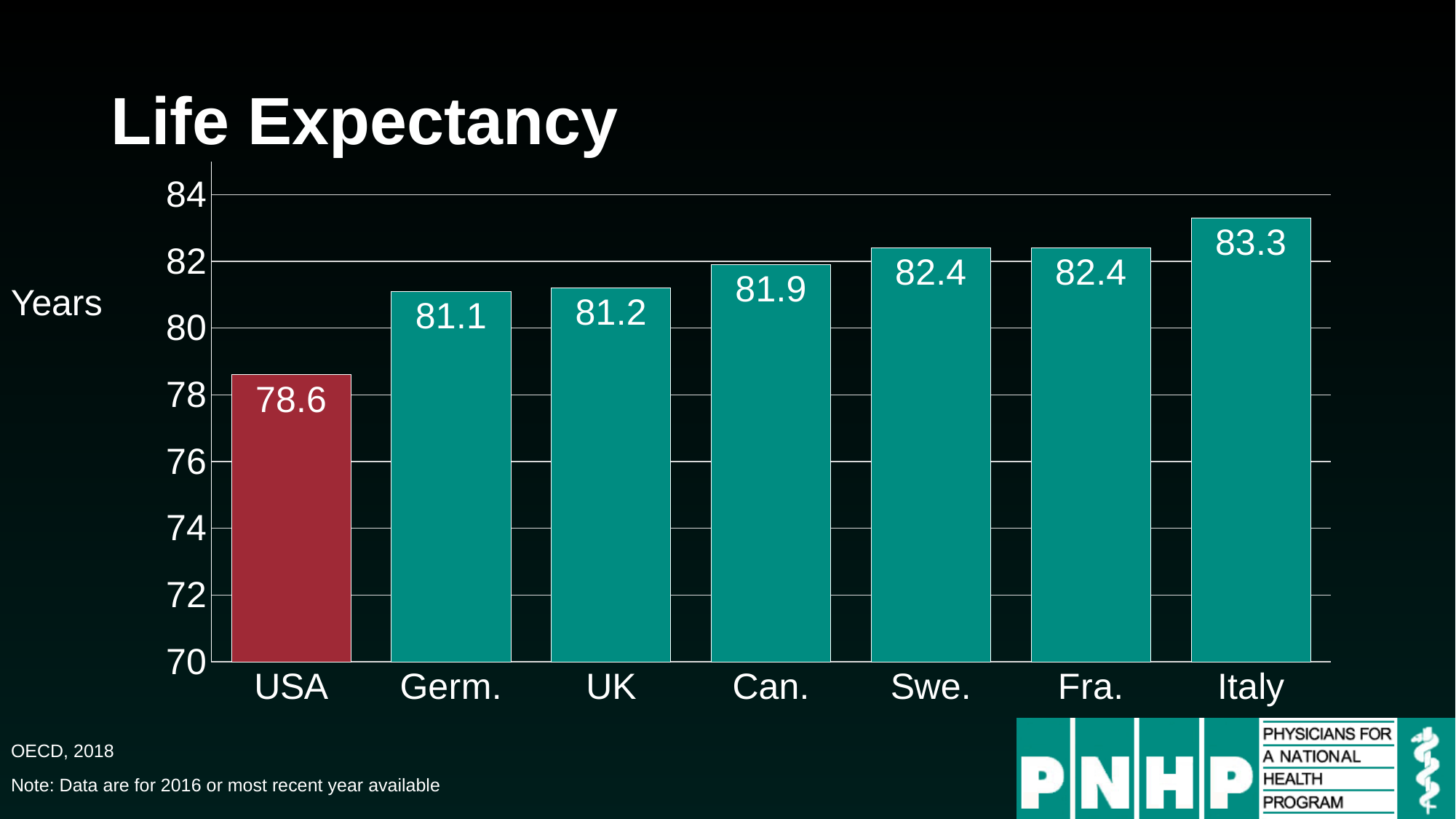
Which has a higher life expectancy, Canada (Can.) or the UK? Can. Which country has the highest life expectancy on the chart? Italy What is the life expectancy value shown for the USA? 78.6 What is the life expectancy value shown for Italy? 83.3 How many countries are shown on the chart? 7 What is the difference in life expectancy between Italy and the USA? 4.7 What is the difference in life expectancy between the UK and Germany (Germ.)? 0.1 What kind of chart is shown on the slide? bar chart Which country has the lowest life expectancy on the chart? USA What is the life expectancy value shown for Canada (Can.)? 81.9 Is the value for the USA greater or less than 80? less Which bar is coloured differently (red) from the others? USA